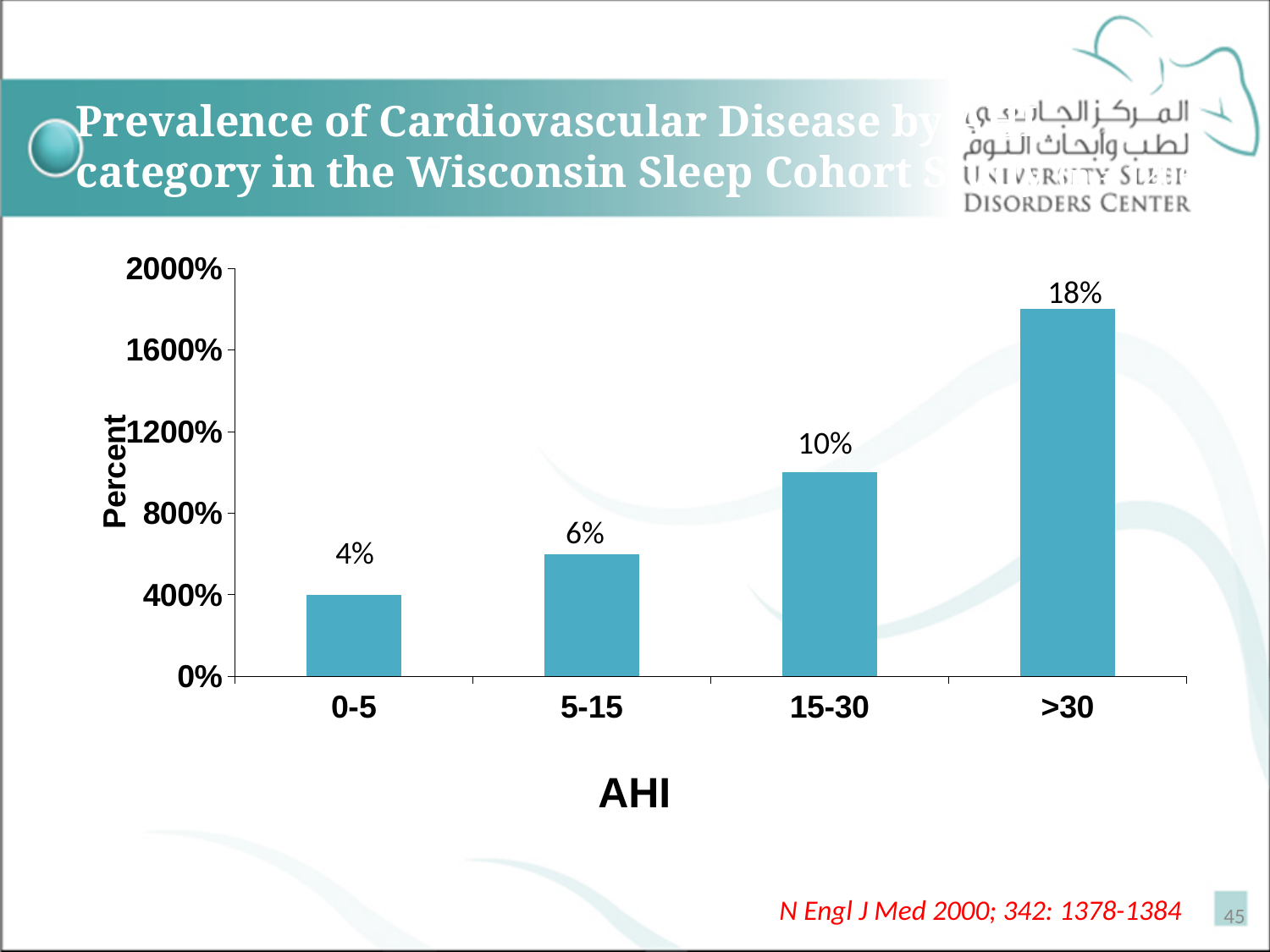
What is the value for the 15-30 AHI category? 10% Which AHI category has the lowest value? 0-5 Do the values rise or fall as AHI increases along the x axis? Rise Which is larger, the value for the 15-30 category or the 5-15 category? 15-30 What is the value for the >30 AHI category? 18% What is the difference between the values for the >30 and 0-5 AHI categories? 14% What is the difference between the values for the 15-30 and 5-15 AHI categories? 4% What kind of chart is shown on the slide? Bar chart What is the value for the 0-5 AHI category? 4% Which AHI category has the highest value? >30 What is the value for the 5-15 AHI category? 6% How many AHI categories are shown on the chart? 4